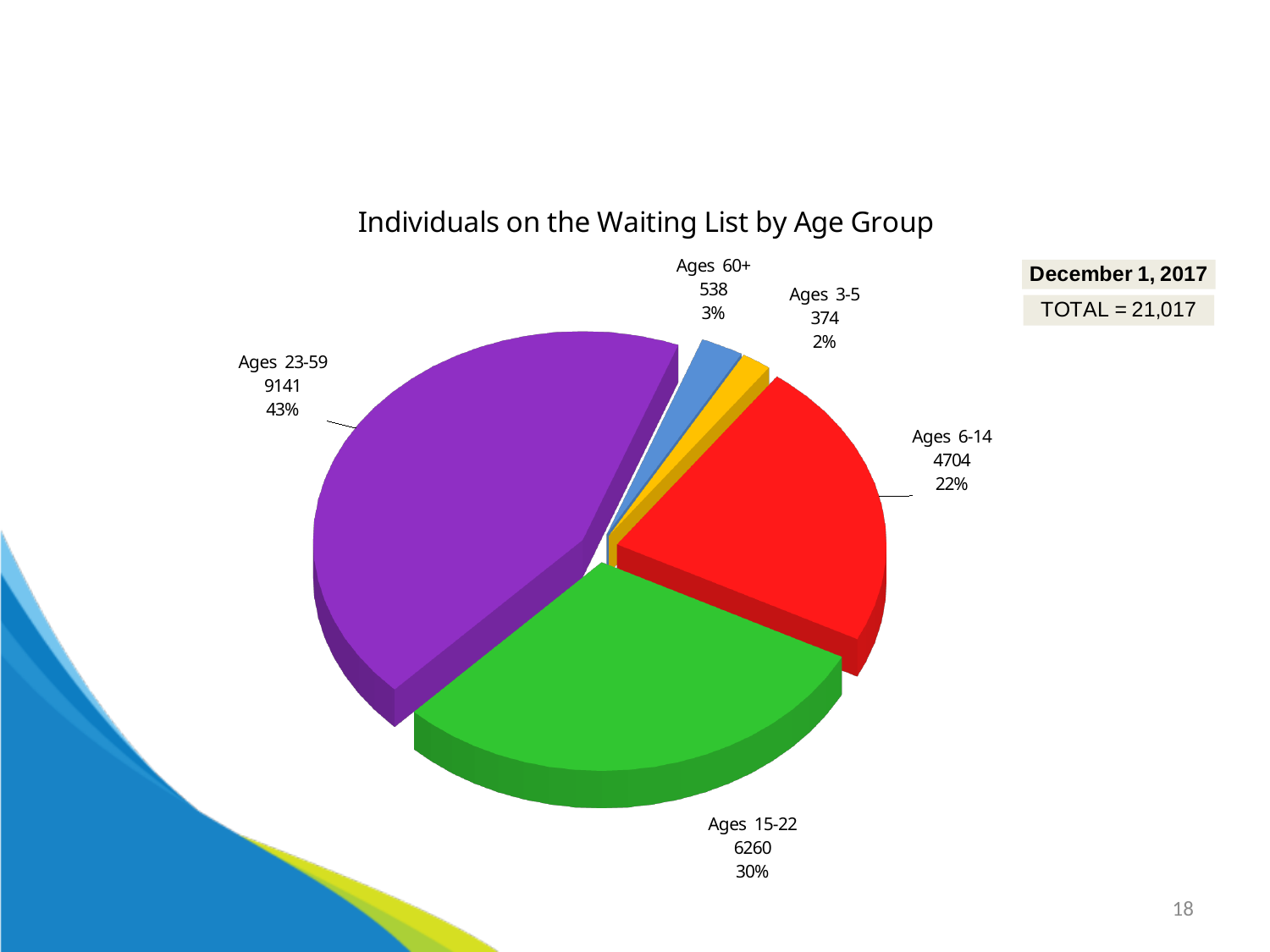
How many individuals are in the Ages 15-22 group? 6260 What kind of chart is shown on the slide? pie chart How many individuals are in the Ages 3-5 group? 374 What is the title of the chart? Individuals on the Waiting List by Age Group How many individuals are in the Ages 23-59 group? 9141 Which age group has the smallest number of individuals on the waiting list? Ages 3-5 Which age group has the largest number of individuals on the waiting list? Ages 23-59 What percentage of the waiting list is the Ages 60+ group? 3% What percentage of the waiting list is the Ages 6-14 group? 22% How many age groups are shown in the pie chart? 5 What is the difference between the number of individuals in Ages 23-59 and Ages 15-22? 2881 Which group has more individuals, Ages 6-14 or Ages 60+? Ages 6-14